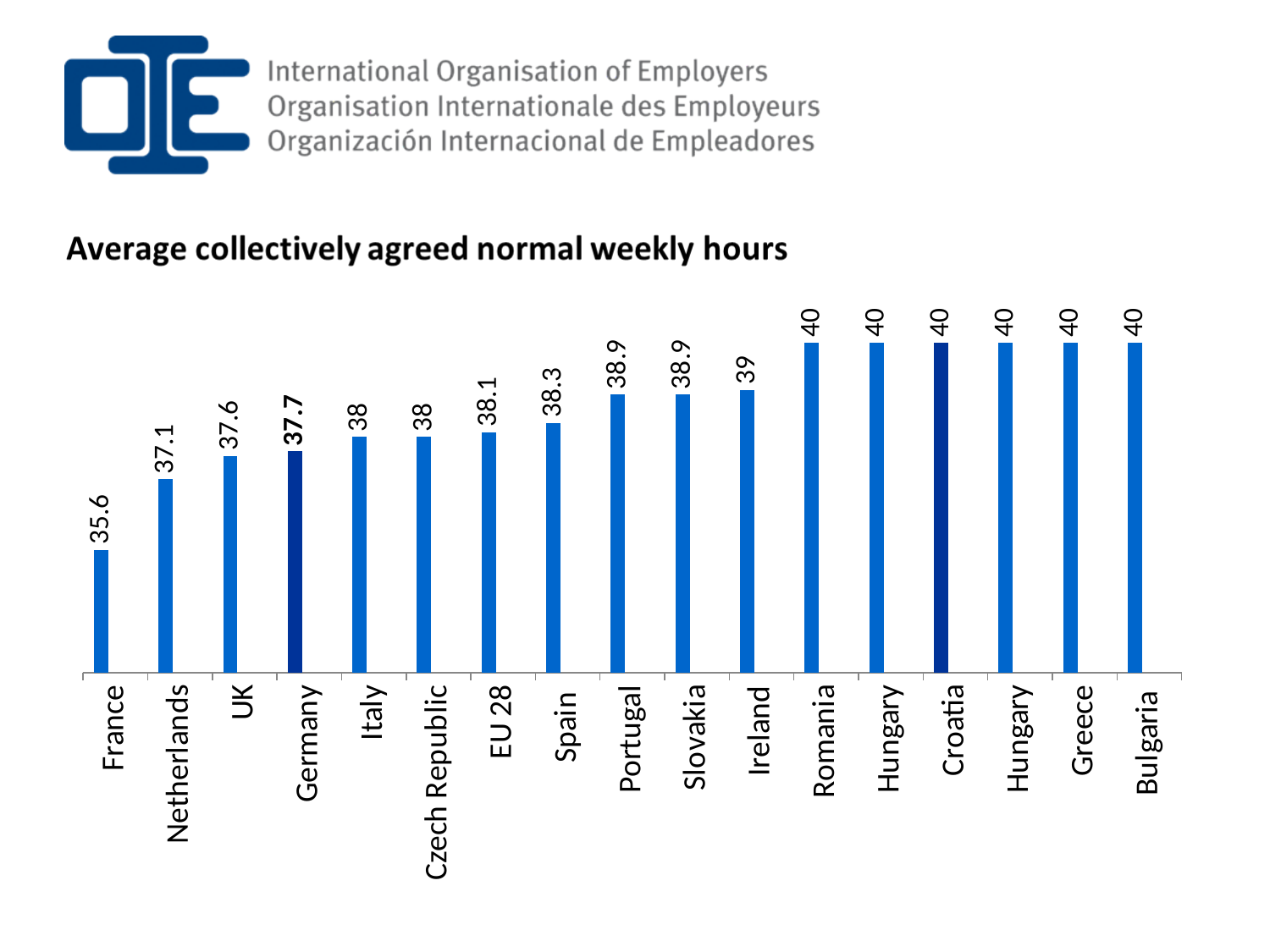
What is the difference between the values for Germany and the Netherlands? 0.6 What is the value for Ireland? 39 What is the average collectively agreed normal weekly hours for France? 35.6 What is the value for EU 28? 38.1 Which has a higher value, the UK or Portugal? Portugal What type of chart is shown on the slide? Bar chart Which country has the lowest average collectively agreed normal weekly hours? France How many bars are shown in the chart? 17 What value is shown for Germany? 37.7 What is the difference between the values for Bulgaria and France? 4.4 What is the value shown for Spain? 38.3 What is the title of the chart? Average collectively agreed normal weekly hours